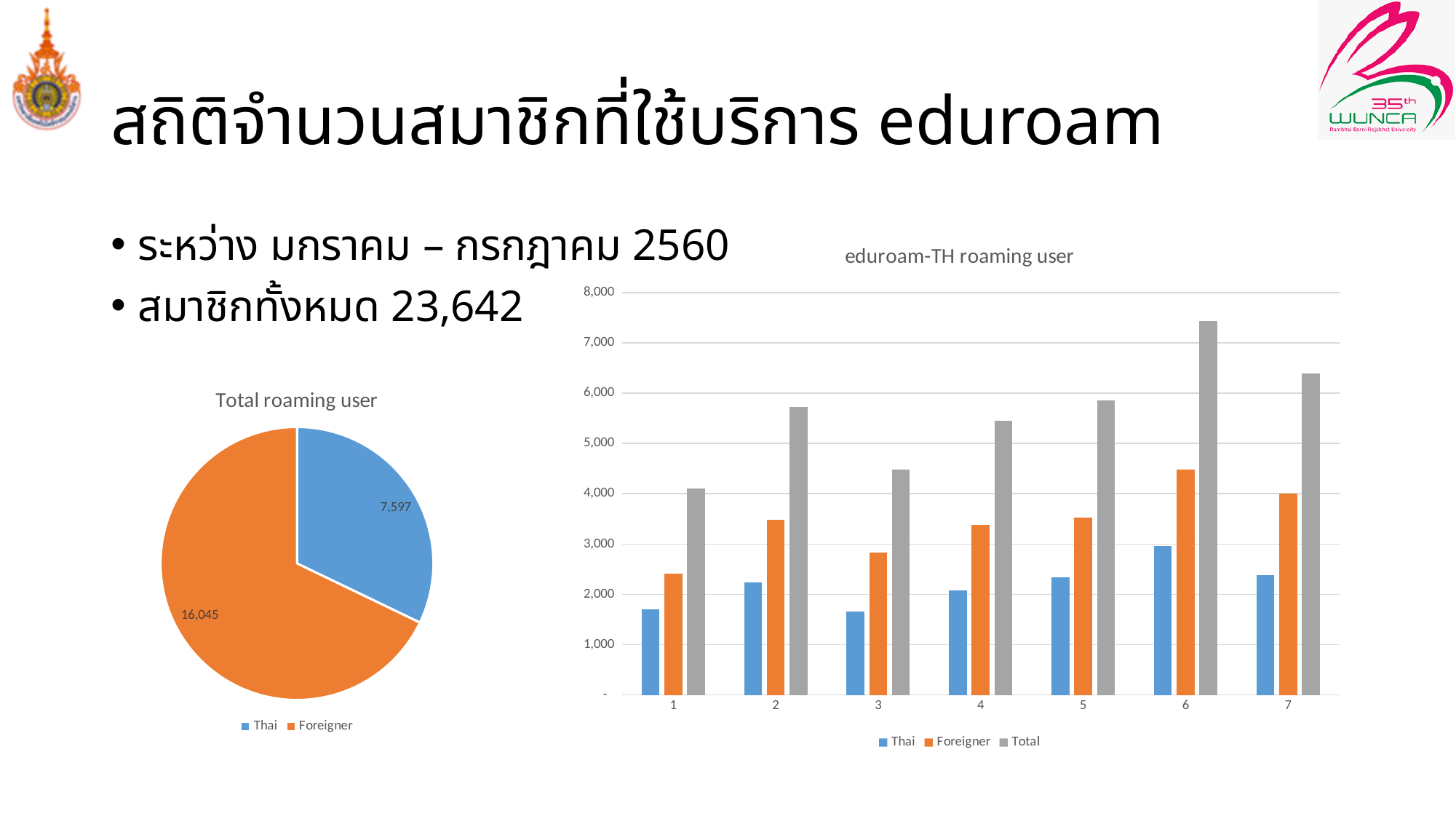
In the chart titled "eduroam-TH roaming user", how many series does the legend list? 3 In the pie chart titled "Total roaming user", what is the value for Thai? 7,597 In the pie chart titled "Total roaming user", what is the difference between the Foreigner and Thai values? 8,448 What kind of chart is the "eduroam-TH roaming user" chart? bar chart In the pie chart titled "Total roaming user", which slice is larger, Thai or Foreigner? Foreigner In the pie chart titled "Total roaming user", what is the value for Foreigner? 16,045 In the chart titled "eduroam-TH roaming user", is the Thai value for category 1 greater or less than 2,000? less In the chart titled "eduroam-TH roaming user", which category has the highest Total value? 6 In the chart titled "eduroam-TH roaming user", is the Total value for category 6 greater or less than 7,000? greater In the pie chart titled "Total roaming user", what share of the total does the Thai slice represent? 32% In the chart titled "eduroam-TH roaming user", how many categories are shown on the x axis? 7 In the chart titled "eduroam-TH roaming user", which is larger for category 4, the Thai value or the Foreigner value? Foreigner